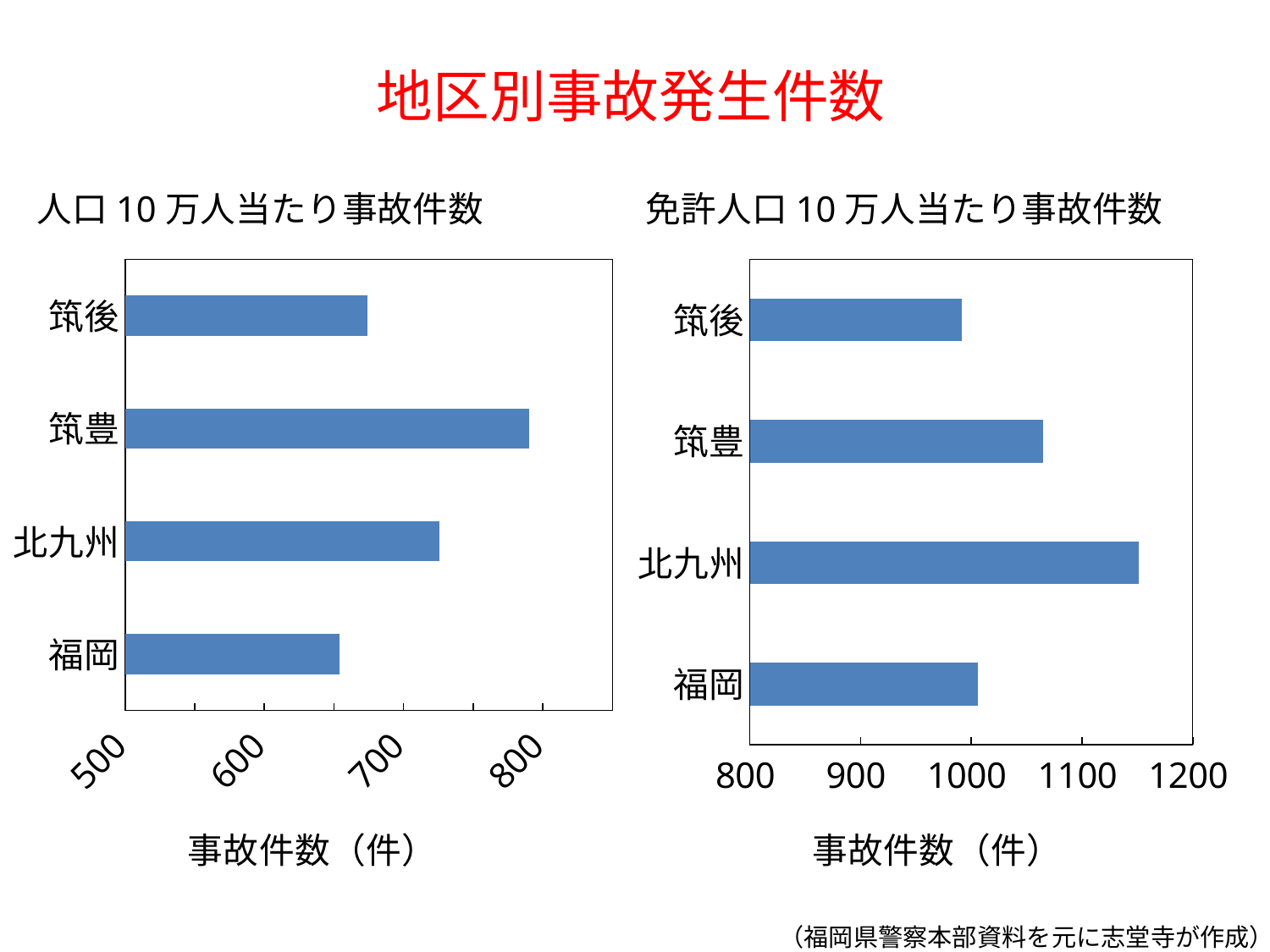
In the left chart (人口10万人当たり事故件数), which is larger, the value for 北九州 or the value for 筑後? 北九州 In the right chart (免許人口10万人当たり事故件数), is the value for 北九州 greater or less than 1100? greater In the left chart (人口10万人当たり事故件数), is the value for 筑豊 greater or less than 700? greater In the left chart (人口10万人当たり事故件数), which district has the lowest value? 福岡 What is the x-axis label of the right chart (免許人口10万人当たり事故件数)? 事故件数（件） In the left chart (人口10万人当たり事故件数), which district has the highest value? 筑豊 In the left chart (人口10万人当たり事故件数), is the value for 筑後 greater or less than 700? less In the right chart (免許人口10万人当たり事故件数), which is larger, the value for 筑豊 or the value for 福岡? 筑豊 What kind of chart is the left chart titled 人口10万人当たり事故件数? bar chart In the right chart (免許人口10万人当たり事故件数), which district has the highest value? 北九州 How many districts are shown in the left chart (人口10万人当たり事故件数)? 4